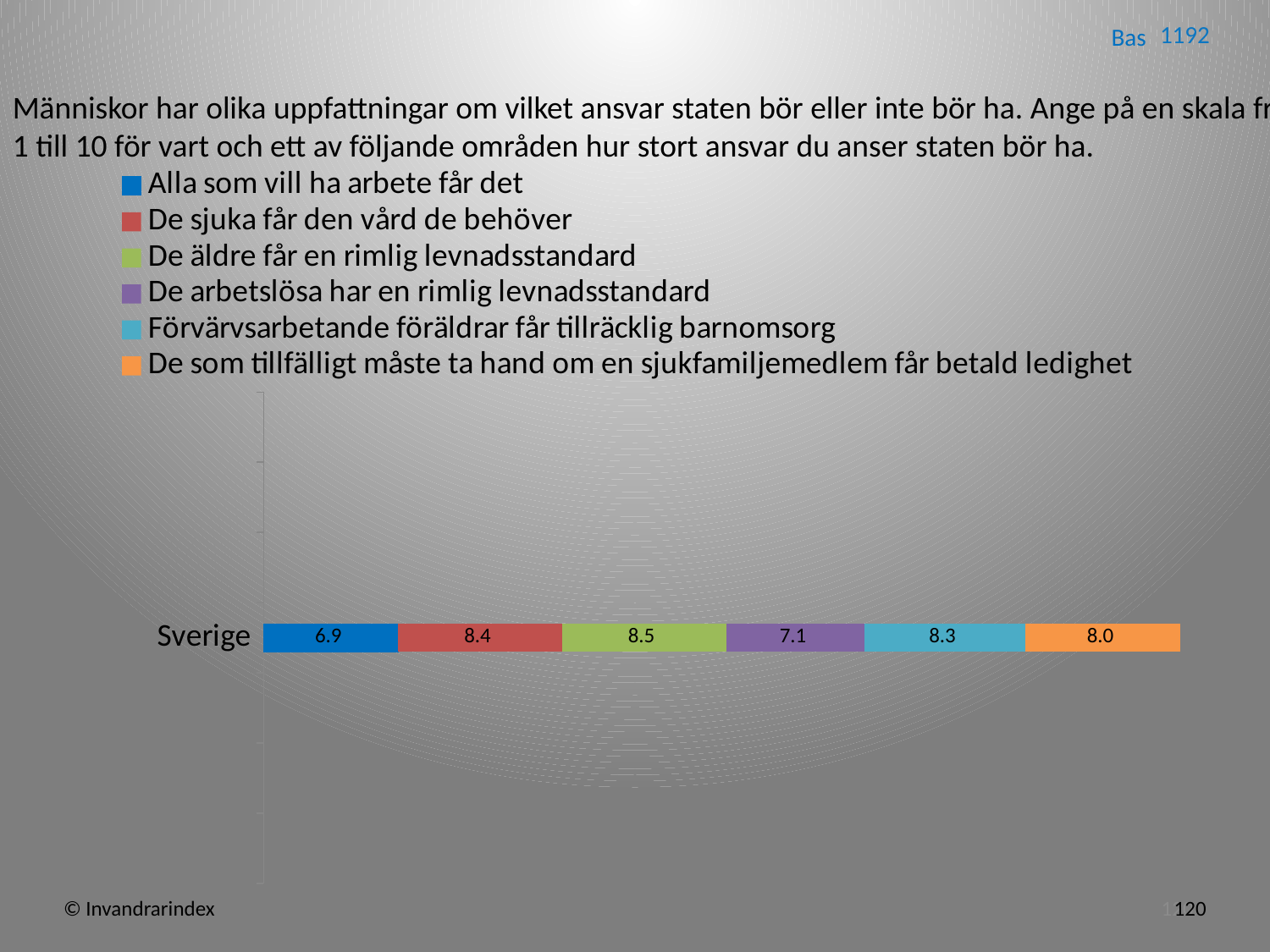
Which is larger for Sverige: 'De sjuka får den vård de behöver' or 'De arbetslösa har en rimlig levnadsstandard'? De sjuka får den vård de behöver Which series has the lowest value for Sverige? Alla som vill ha arbete får det What is the value for 'De sjuka får den vård de behöver' for Sverige? 8.4 What is the value for 'De arbetslösa har en rimlig levnadsstandard' for Sverige? 7.1 Which series has the highest value for Sverige? De äldre får en rimlig levnadsstandard What is the difference between the values for 'De äldre får en rimlig levnadsstandard' and 'Alla som vill ha arbete får det' for Sverige? 1.6 What is the value for 'Alla som vill ha arbete får det' for Sverige? 6.9 How many series does the legend list? 6 What is the value for 'De som tillfälligt måste ta hand om en sjukfamiljemedlem får betald ledighet' for Sverige? 8.0 What is the value for 'De äldre får en rimlig levnadsstandard' for Sverige? 8.5 What kind of chart is shown on the slide? Stacked bar chart What is the value for 'Förvärvsarbetande föräldrar får tillräcklig barnomsorg' for Sverige? 8.3